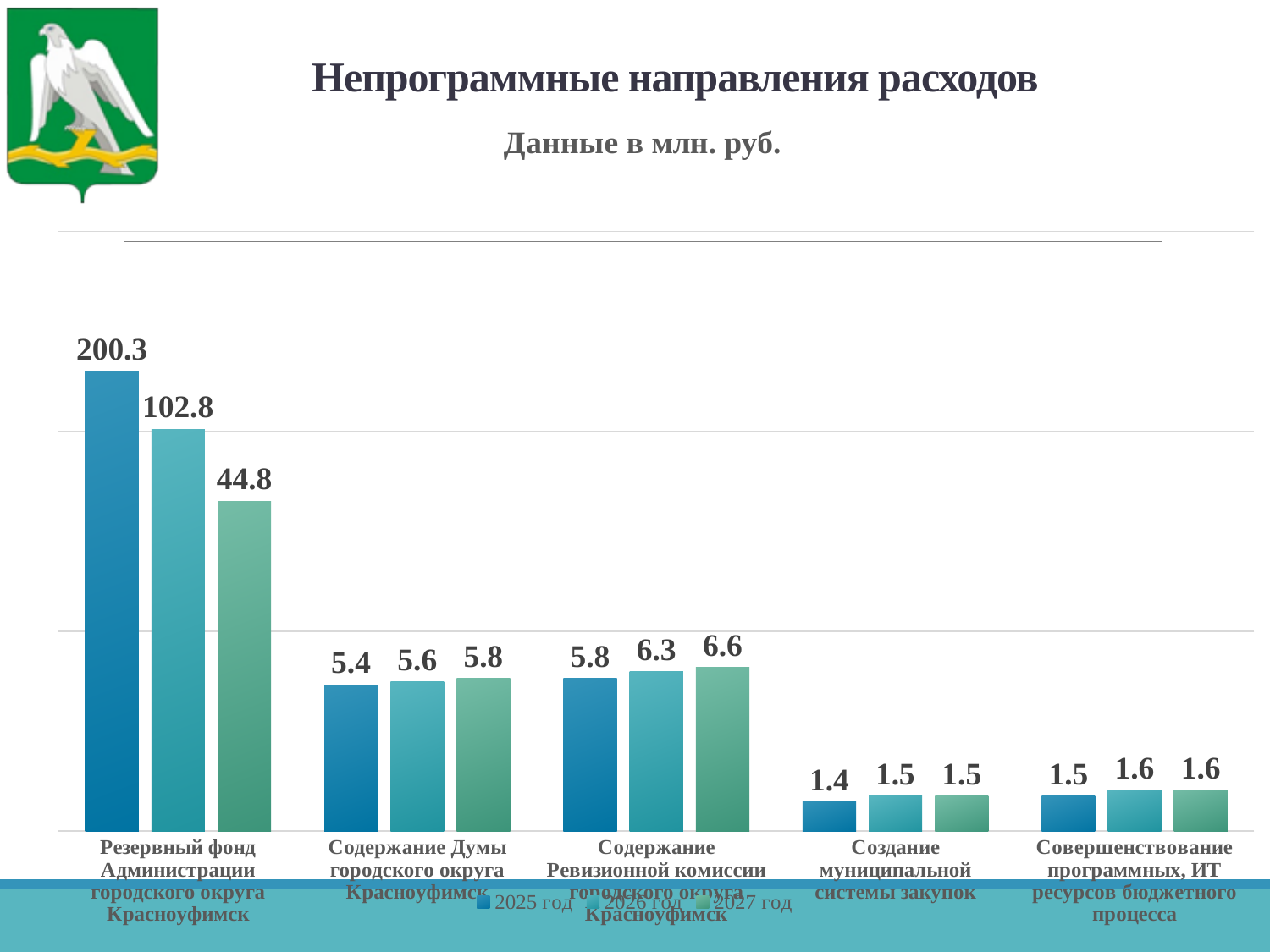
What is the value for Содержание Ревизионной комиссии городского округа Красноуфимск in 2027 год? 6.6 How many series does the legend list? 3 What is the value for Создание муниципальной системы закупок in 2025 год? 1.4 What is the value for Резервный фонд Администрации городского округа Красноуфимск in 2025 год? 200.3 How many categories are shown on the x axis? 5 Which category has the highest value in 2026 год? Резервный фонд Администрации городского округа Красноуфимск Which category has the lowest value in 2025 год? Создание муниципальной системы закупок Do the values for Содержание Ревизионной комиссии городского округа Красноуфимск rise or fall from 2025 год to 2027 год? Rise What kind of chart is shown on the slide? Bar chart What is the difference between the 2025 год and 2027 год values for Резервный фонд Администрации городского округа Красноуфимск? 155.5 Which is larger: the 2027 год value for Содержание Думы городского округа Красноуфимск or the 2027 год value for Содержание Ревизионной комиссии городского округа Красноуфимск? Содержание Ревизионной комиссии городского округа Красноуфимск What unit is stated in the chart subtitle? млн. руб.